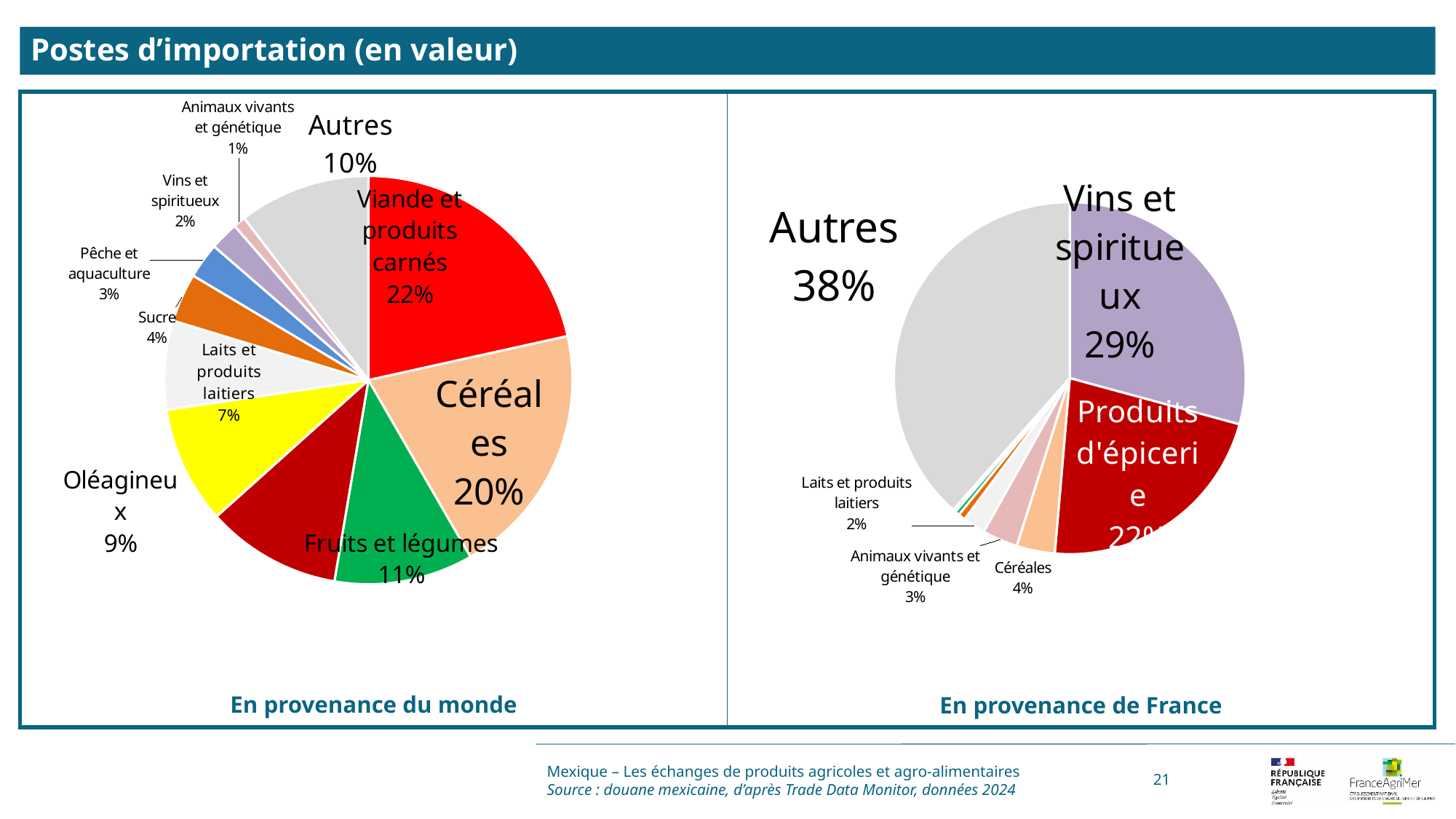
In the 'En provenance de France' pie chart, what share is shown for 'Céréales'? 4% In the 'En provenance du monde' pie chart, which labelled category has the smallest share? Animaux vivants et génétique In the 'En provenance de France' pie chart, which category has the largest share? Autres Is the share of 'Céréales' larger in the 'En provenance du monde' chart or in the 'En provenance de France' chart? En provenance du monde In the 'En provenance du monde' pie chart, what share is shown for 'Céréales'? 20% In the 'En provenance du monde' pie chart, what is the difference in percentage points between 'Céréales' and 'Fruits et légumes'? 9 percentage points In the 'En provenance du monde' pie chart, what share is shown for 'Oléagineux'? 9% In the 'En provenance de France' pie chart, what share is shown for 'Autres'? 38% In the 'En provenance du monde' pie chart, what share is shown for 'Viande et produits carnés'? 22% In the 'En provenance du monde' pie chart, which labelled category has the largest share? Viande et produits carnés In the 'En provenance de France' pie chart, what share is shown for 'Vins et spiritueux'? 29% What type of chart is used on this slide for both 'En provenance du monde' and 'En provenance de France'? Pie chart